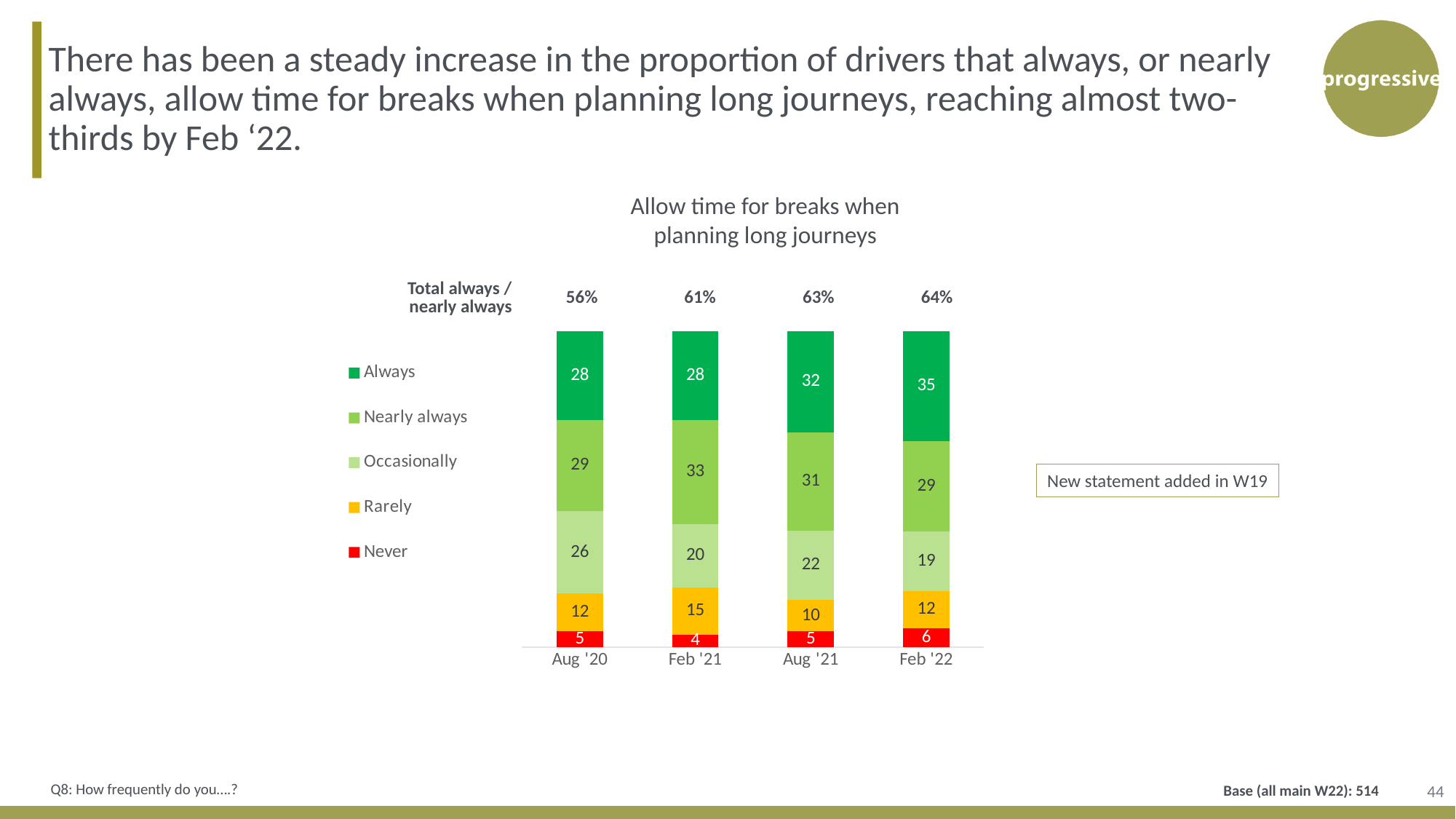
How many periods are shown on the x axis? 4 What kind of chart is shown? Stacked bar chart What is the value for Occasionally in Aug '20? 26 In which period is the Always value highest? Feb '22 What is the value for Always in Feb '22? 35 What is the value for Rarely in Feb '21? 15 What is the difference between the Nearly always values for Feb '21 and Aug '20? 4 Does the 'Total always / nearly always' figure rise or fall from Aug '20 to Feb '22? Rise What is the 'Total always / nearly always' figure shown for Aug '21? 63% Which is larger, the Occasionally value in Aug '21 or in Feb '22? Aug '21 In which period is the Never value lowest? Feb '21 How many series does the legend list? 5